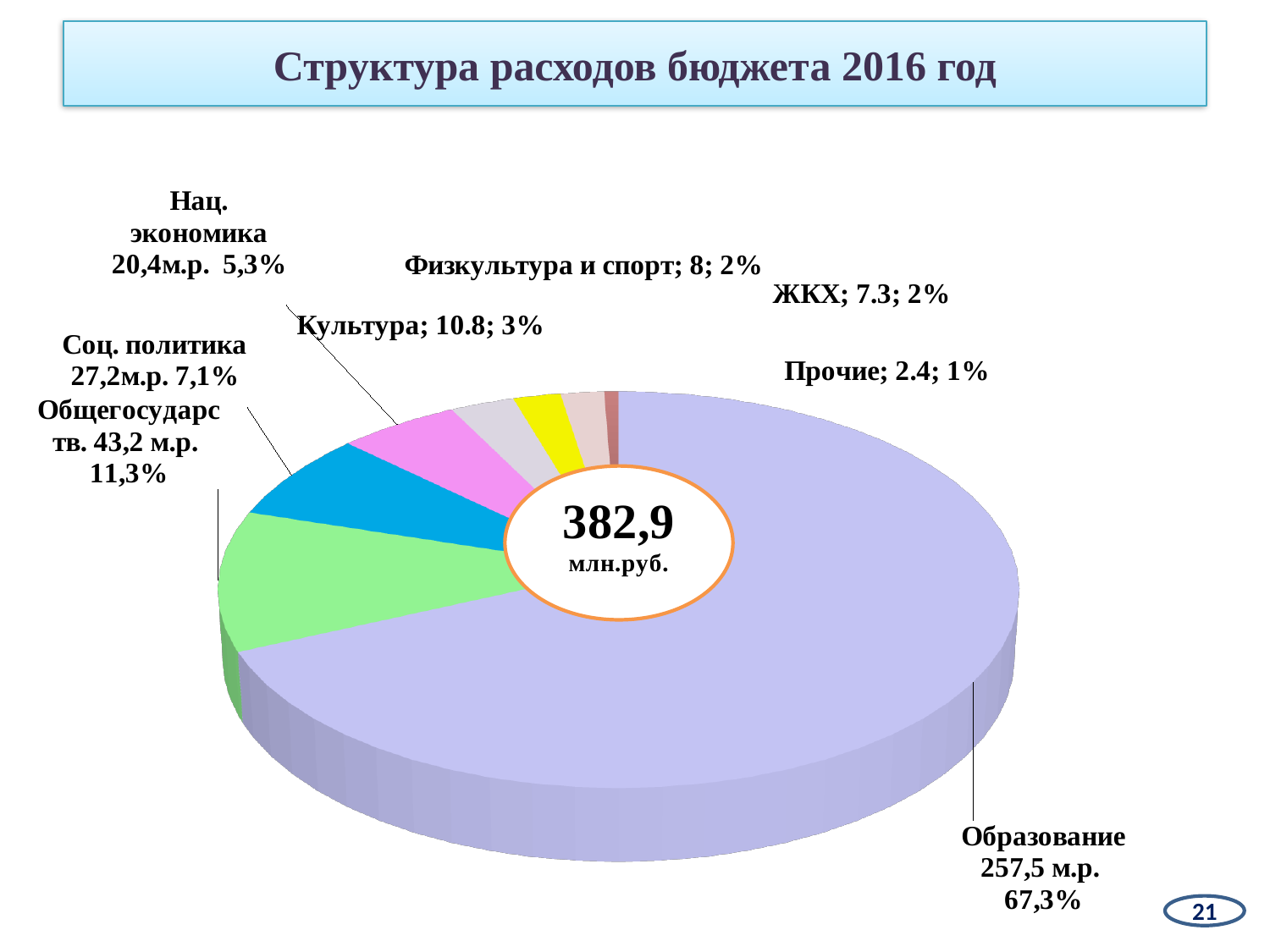
Which is larger, the value for Нац. экономика or the value for ЖКХ? Нац. экономика What total amount is shown in the centre of the pie chart? 382,9 млн.руб. What is the value shown for Соц. политика? 27,2 м.р. What is the value shown for Культура? 10.8 What is the title of the chart? Структура расходов бюджета 2016 год What share of the pie does Образование represent? 67,3% Which category has the largest slice of the pie? Образование What is the value shown for Образование? 257,5 м.р. How many categories (slices) does the pie chart have? 8 What share of the pie does Общегосударств. represent? 11,3% Which category has the smallest slice of the pie? Прочие What kind of chart is shown on the slide? pie chart